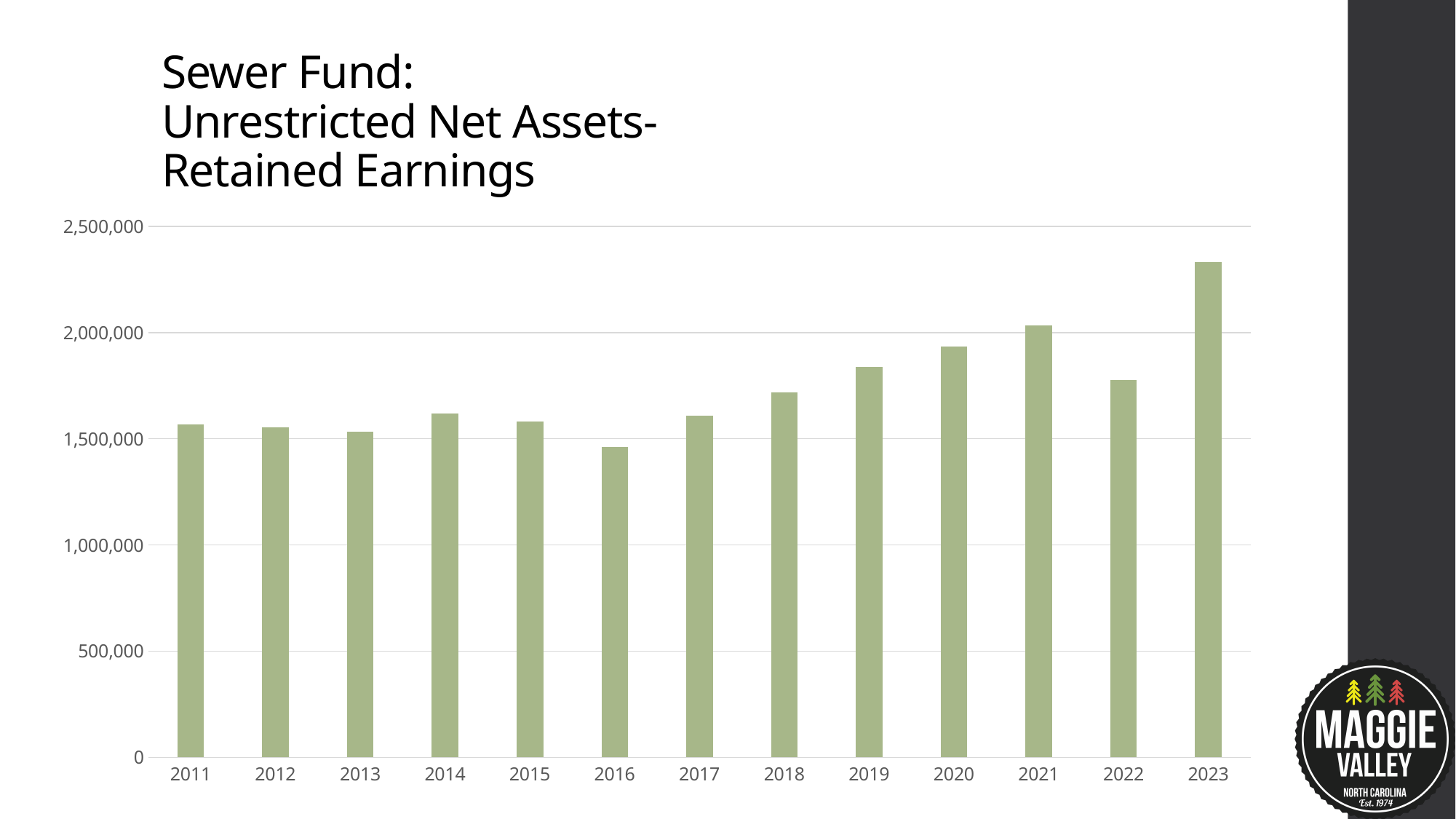
Which year has the lowest unrestricted net assets value? 2016 How many years are plotted on the chart? 13 Is the value for 2021 greater or less than 2,000,000? greater What is the title of the chart? Sewer Fund: Unrestricted Net Assets- Retained Earnings Which year has the highest unrestricted net assets value? 2023 Is the value for 2023 greater or less than 2,000,000? greater Is the value for 2016 greater or less than 1,500,000? less Do the values generally rise or fall from 2016 to 2021? rise What kind of chart is shown on the slide? bar chart Which year has the larger value, 2021 or 2022? 2021